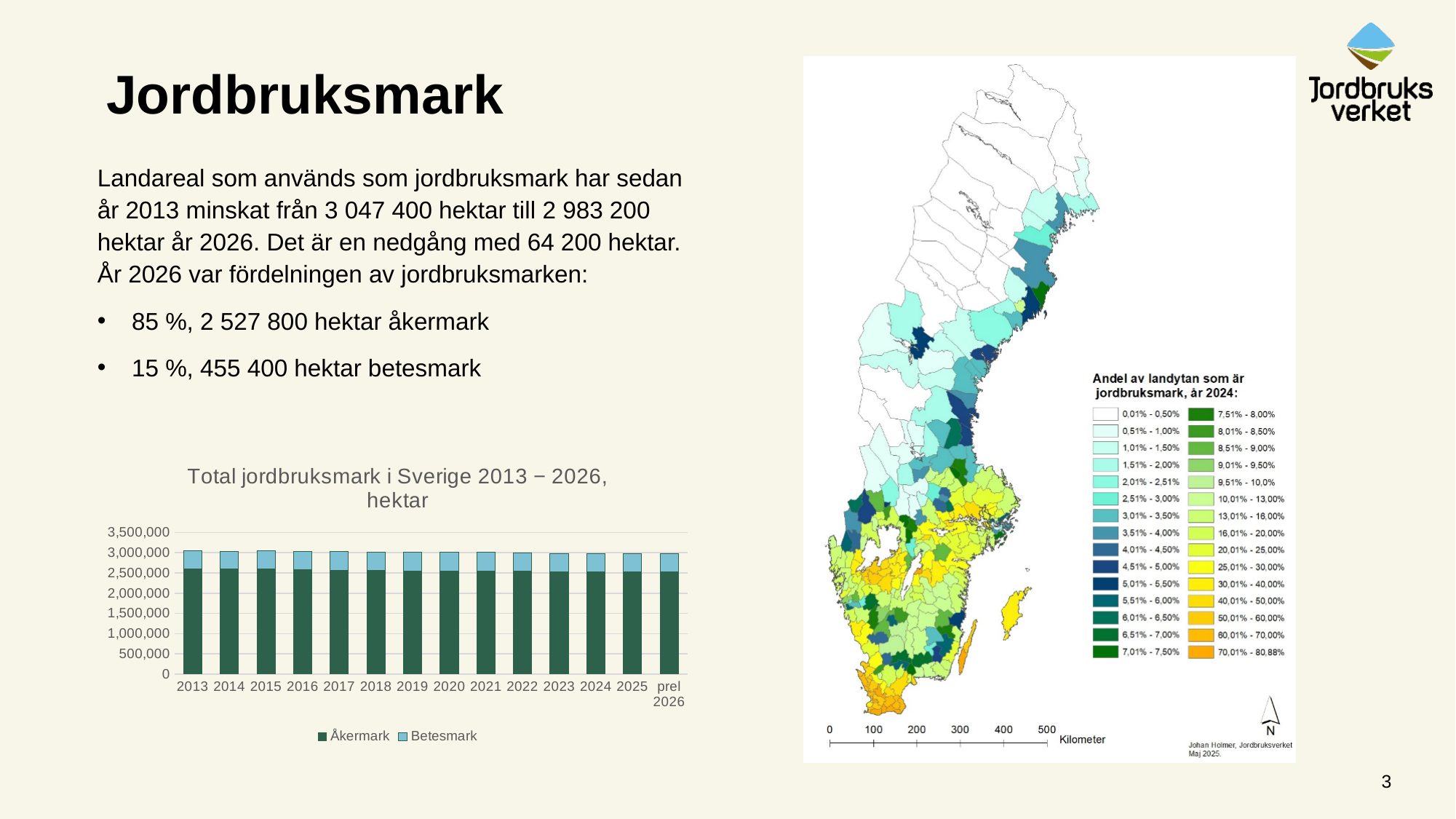
In the bar chart, is the value for Betesmark in 2020 greater or less than 1,000,000? less In the bar chart, is the value for Åkermark in 2013 greater or less than 2,000,000? greater How many series does the legend of the bar chart list? 2 In the bar chart, is the total height of the prel 2026 bar greater or less than 3,500,000? less In the bar chart, which series is larger in 2013, Åkermark or Betesmark? Åkermark What is the label of the last category on the x axis of the bar chart? prel 2026 Do the total bar heights in the bar chart rise or fall from 2013 to prel 2026? fall What kind of chart is shown on the slide? Stacked bar chart What is the title of the bar chart? Total jordbruksmark i Sverige 2013 − 2026, hektar How many years (categories) are shown on the x axis of the bar chart? 14 Which series are listed in the legend of the bar chart? Åkermark and Betesmark